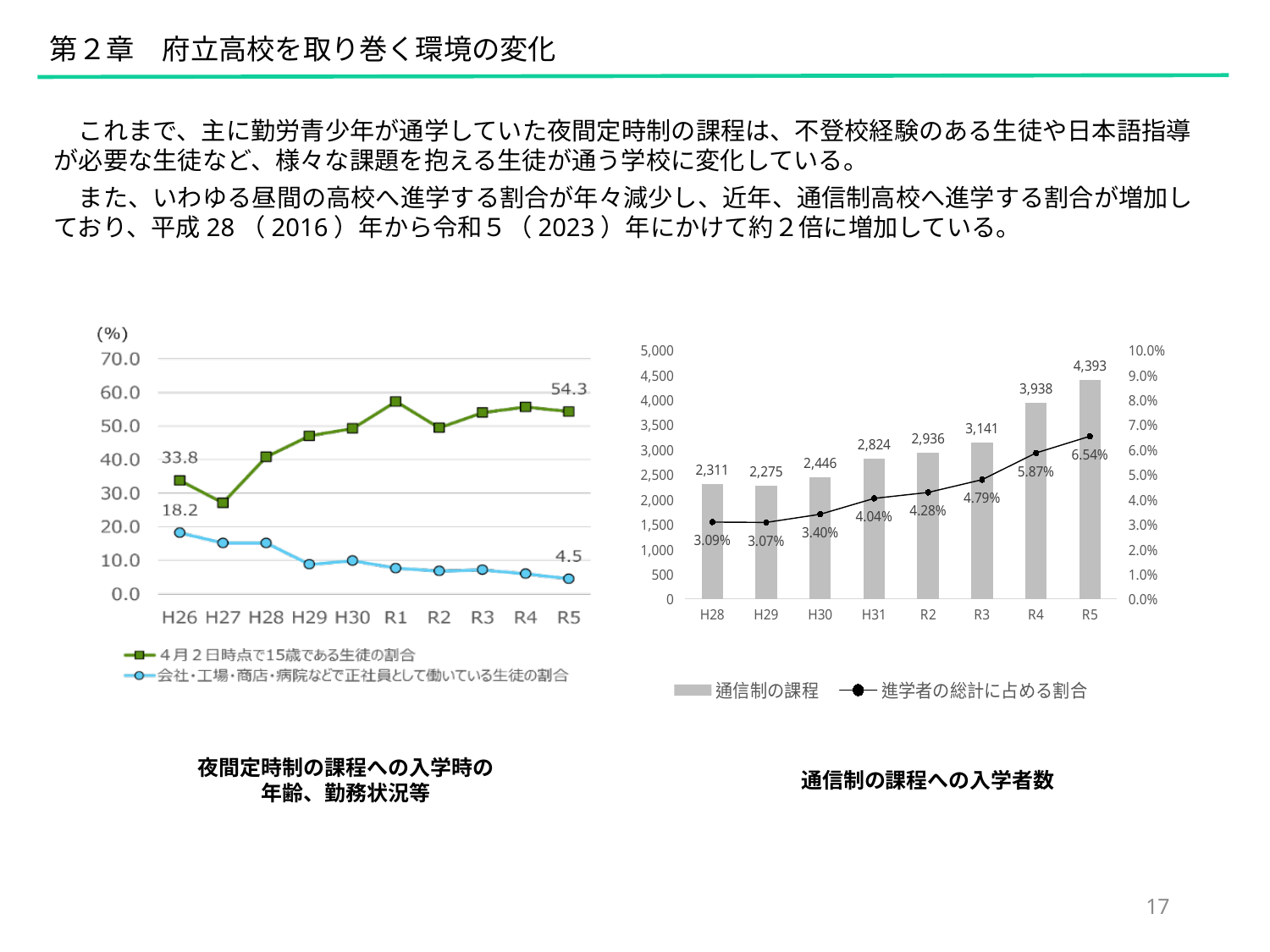
In the right chart (通信制の課程への入学者数), what is the value of 通信制の課程 for R5? 4,393 In the right chart (通信制の課程への入学者数), does the 進学者の総計に占める割合 line generally rise or fall from H28 to R5? rise In the left chart (夜間定時制の課程への入学時の年齢、勤務状況等), what is the value of 4月2日時点で15歳である生徒の割合 for R5? 54.3 What type of chart is the left chart (夜間定時制の課程への入学時の年齢、勤務状況等)? line chart In the right chart (通信制の課程への入学者数), what is the difference between the 通信制の課程 values for R5 and H28? 2,082 In the right chart (通信制の課程への入学者数), how many years are shown on the x axis? 8 In the right chart (通信制の課程への入学者数), which year has the lowest 通信制の課程 value? H29 In the left chart (夜間定時制の課程への入学時の年齢、勤務状況等), how many series does the legend list? 2 In the left chart (夜間定時制の課程への入学時の年齢、勤務状況等), what is the value of 会社・工場・商店・病院などで正社員として働いている生徒の割合 for H26? 18.2 In the left chart (夜間定時制の課程への入学時の年齢、勤務状況等), does the 会社・工場・商店・病院などで正社員として働いている生徒の割合 line rise or fall from H26 to R5? fall In the left chart (夜間定時制の課程への入学時の年齢、勤務状況等), is the value of 4月2日時点で15歳である生徒の割合 for H27 greater or less than 30.0? less In the right chart (通信制の課程への入学者数), what is the 進学者の総計に占める割合 for H31? 4.04%